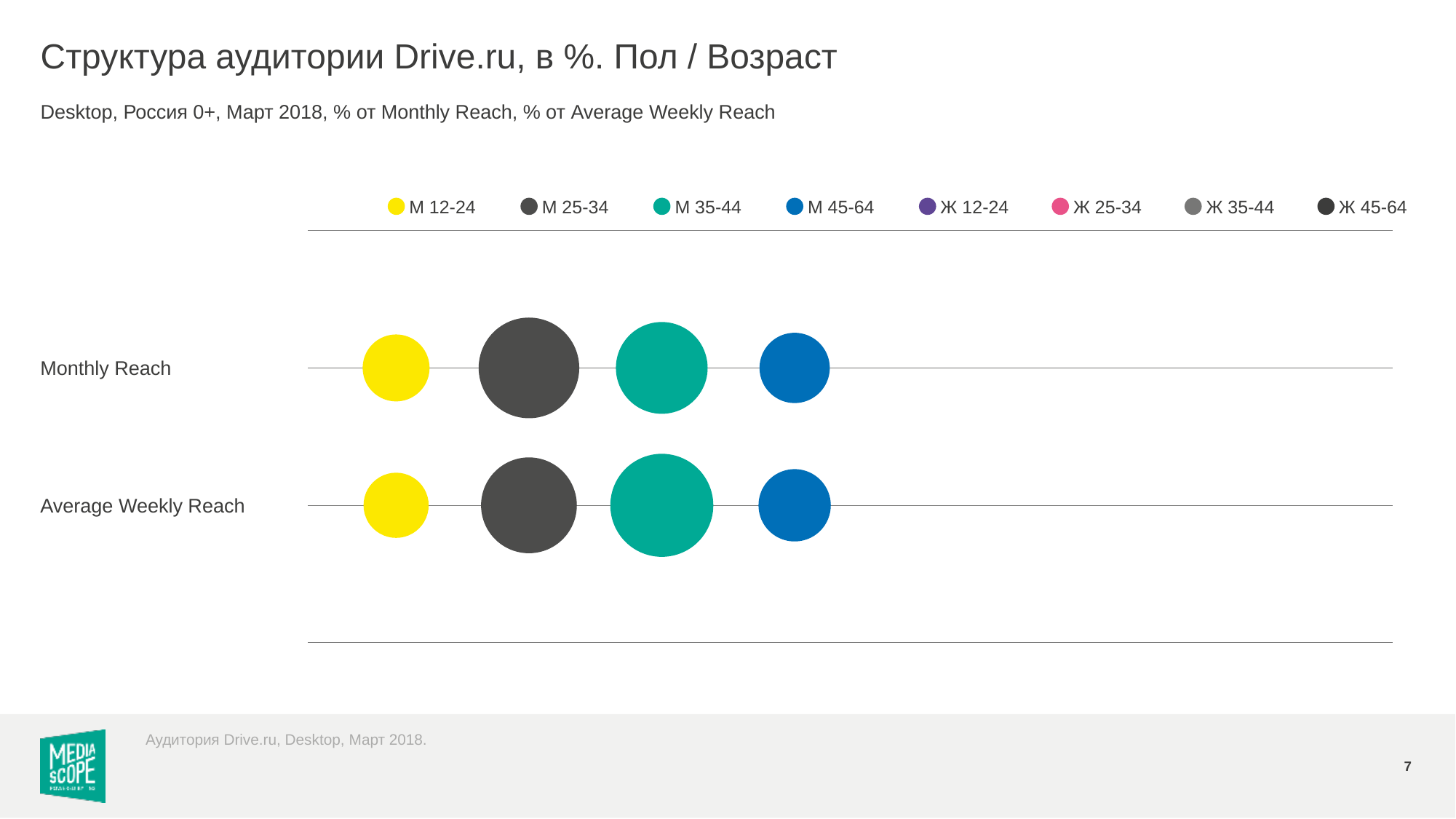
In the Monthly Reach row, which bubble is larger: М 25-34 or М 12-24? М 25-34 Which age group has the largest bubble in the Average Weekly Reach row? М 35-44 What kind of chart is shown on the slide? Bubble chart How many series does the legend list? 8 In the Average Weekly Reach row, which bubble is larger: М 35-44 or М 45-64? М 35-44 How many bubbles are visible in the Monthly Reach row? 4 What is the title of the slide? Структура аудитории Drive.ru, в %. Пол / Возраст How many rows (categories) are plotted on the chart? 2 In the Monthly Reach row, which bubble is larger: М 35-44 or М 12-24? М 35-44 What colour represents М 12-24 in the legend? Yellow Which age group has the largest bubble in the Monthly Reach row? М 25-34